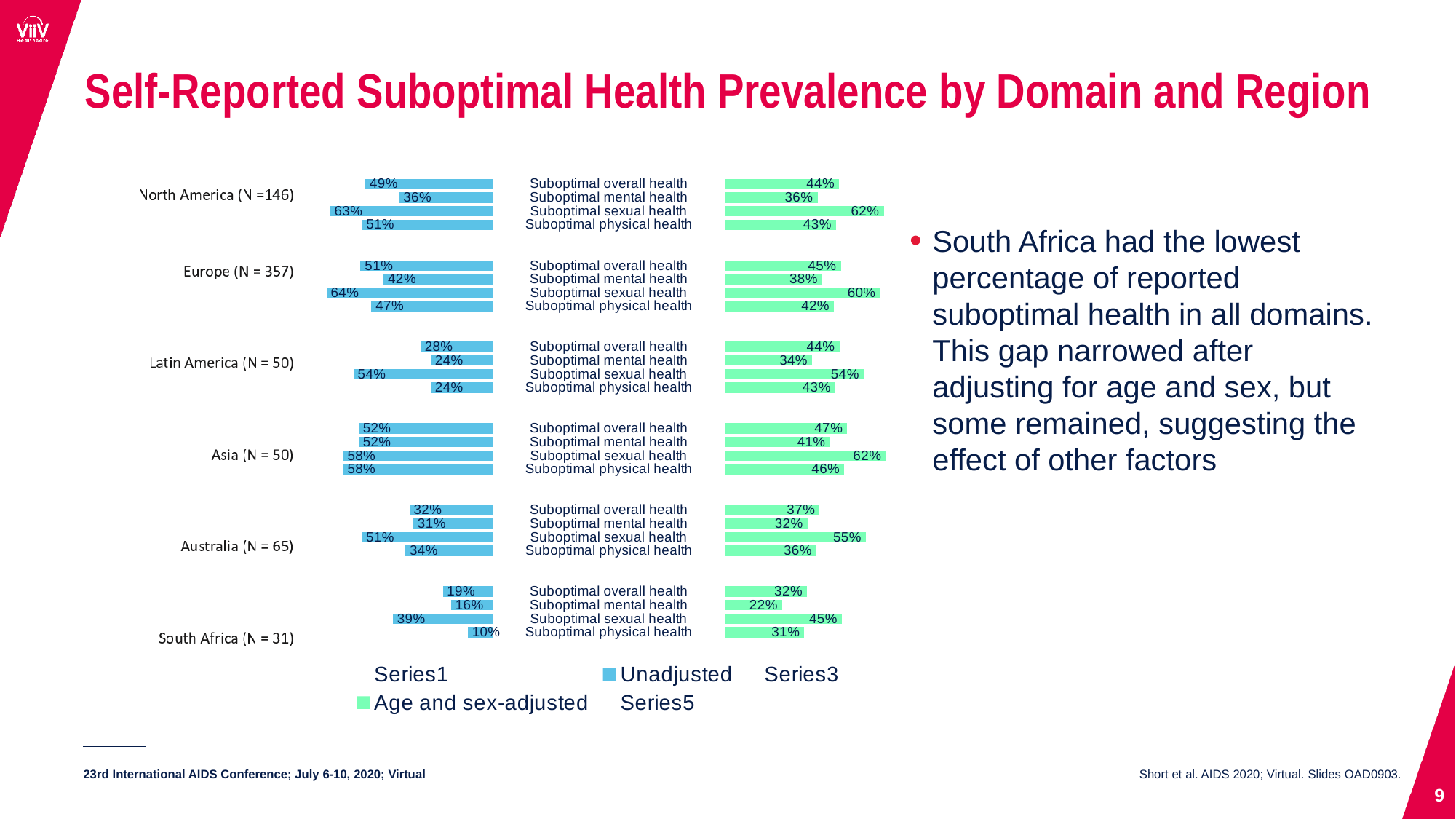
For Asia, which domain has the highest age and sex-adjusted percentage? Suboptimal sexual health Which is larger: the unadjusted suboptimal mental health percentage for Asia or for Australia? Asia Which region has the lowest unadjusted percentage for suboptimal physical health? South Africa What is the unadjusted percentage for suboptimal sexual health in Europe? 64% What colour represents the age and sex-adjusted values in the chart? Green What is the difference between the age and sex-adjusted and unadjusted percentages for suboptimal overall health in Latin America? 16 percentage points What is the unadjusted percentage for suboptimal overall health in Latin America? 28% What type of chart is shown on the slide? Bar chart Which region has the highest unadjusted percentage for suboptimal sexual health? Europe How many regions are shown in the chart? 6 What is the age and sex-adjusted percentage for suboptimal physical health in South Africa? 31% What is the age and sex-adjusted percentage for suboptimal sexual health in Australia? 55%